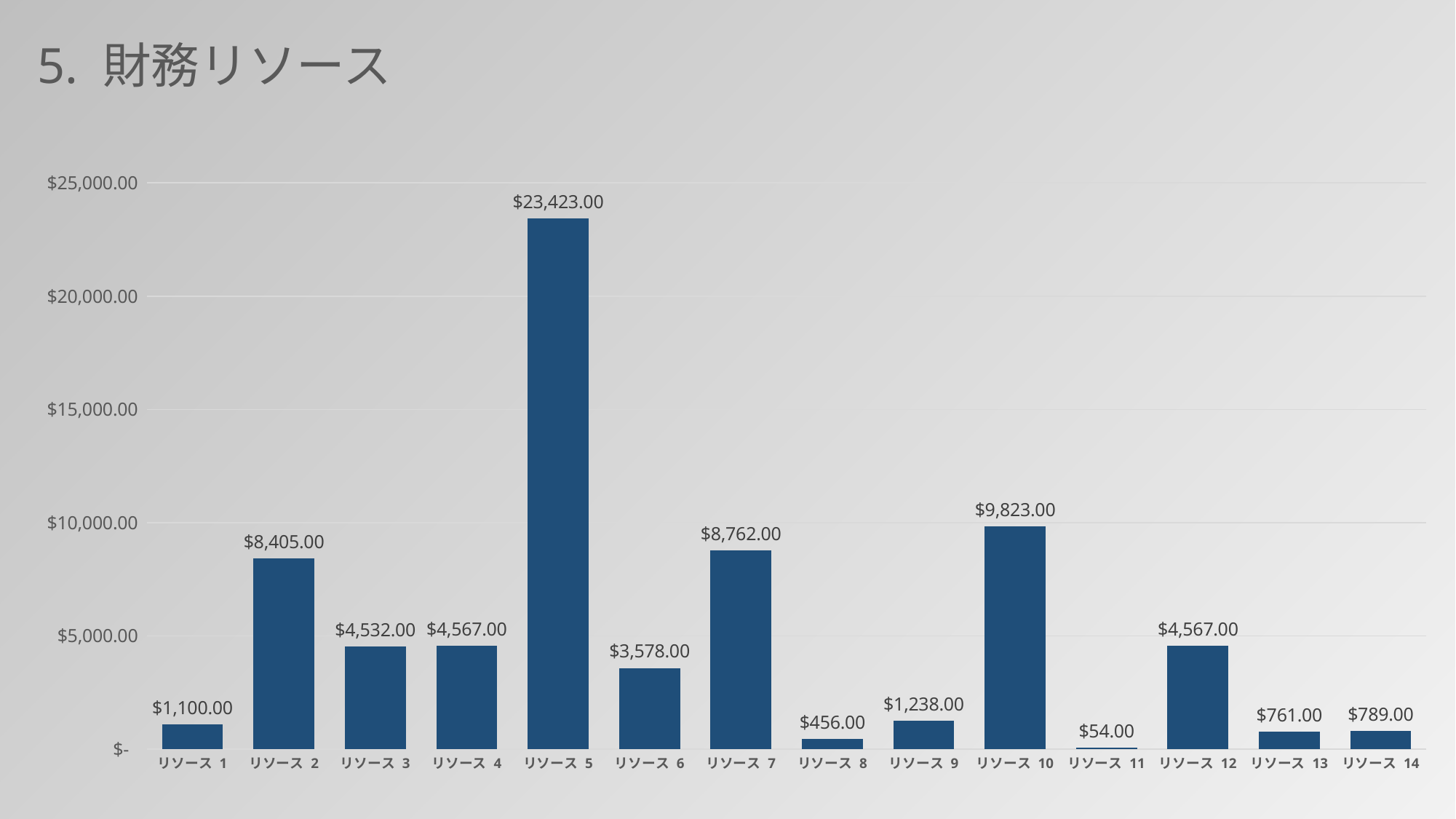
What kind of chart is shown on the slide? bar chart What is the title of the slide? 5. 財務リソース What is the difference between the values for リソース 2 and リソース 7? $357.00 What is the value for リソース 5? $23,423.00 Which category has the lowest value? リソース 11 How many categories are shown on the x axis? 14 Which is larger, the value for リソース 6 or the value for リソース 9? リソース 6 What is the value for リソース 11? $54.00 Which category has the highest value? リソース 5 Is the value for リソース 10 greater or less than $5,000.00? greater What is the value for リソース 10? $9,823.00 What is the value for リソース 13? $761.00